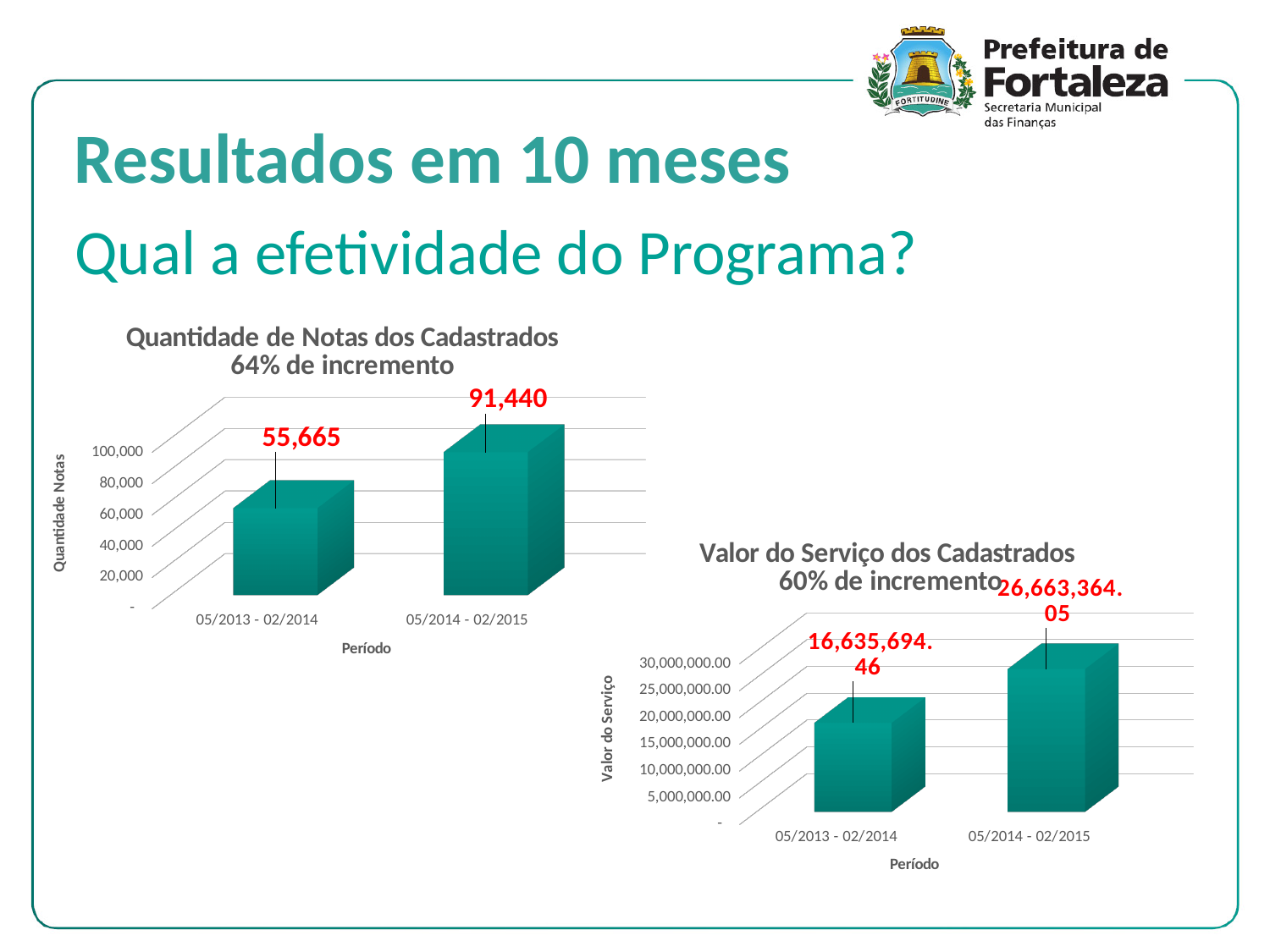
In the 'Quantidade de Notas dos Cadastrados' chart, what is the value for 05/2013 - 02/2014? 55,665 In the 'Valor do Serviço dos Cadastrados' chart, what is the value for 05/2013 - 02/2014? 16,635,694.46 How many periods are shown in the 'Quantidade de Notas dos Cadastrados' chart? 2 In the 'Valor do Serviço dos Cadastrados' chart, what is the value for 05/2014 - 02/2015? 26,663,364.05 In the 'Valor do Serviço dos Cadastrados' chart, what is the difference between the values for 05/2014 - 02/2015 and 05/2013 - 02/2014? 10,027,669.59 In the 'Quantidade de Notas dos Cadastrados' chart, which period has the highest value? 05/2014 - 02/2015 In the 'Valor do Serviço dos Cadastrados' chart, which period has the lowest value? 05/2013 - 02/2014 In the 'Quantidade de Notas dos Cadastrados' chart, what is the difference between the values for 05/2014 - 02/2015 and 05/2013 - 02/2014? 35,775 In the 'Quantidade de Notas dos Cadastrados' chart, what is the value for 05/2014 - 02/2015? 91,440 What percentage increase is stated in the title of the 'Quantidade de Notas dos Cadastrados' chart? 64% In the 'Valor do Serviço dos Cadastrados' chart, is the value for 05/2014 - 02/2015 greater or less than 25,000,000.00? greater What kind of chart is the 'Valor do Serviço dos Cadastrados' chart? bar chart